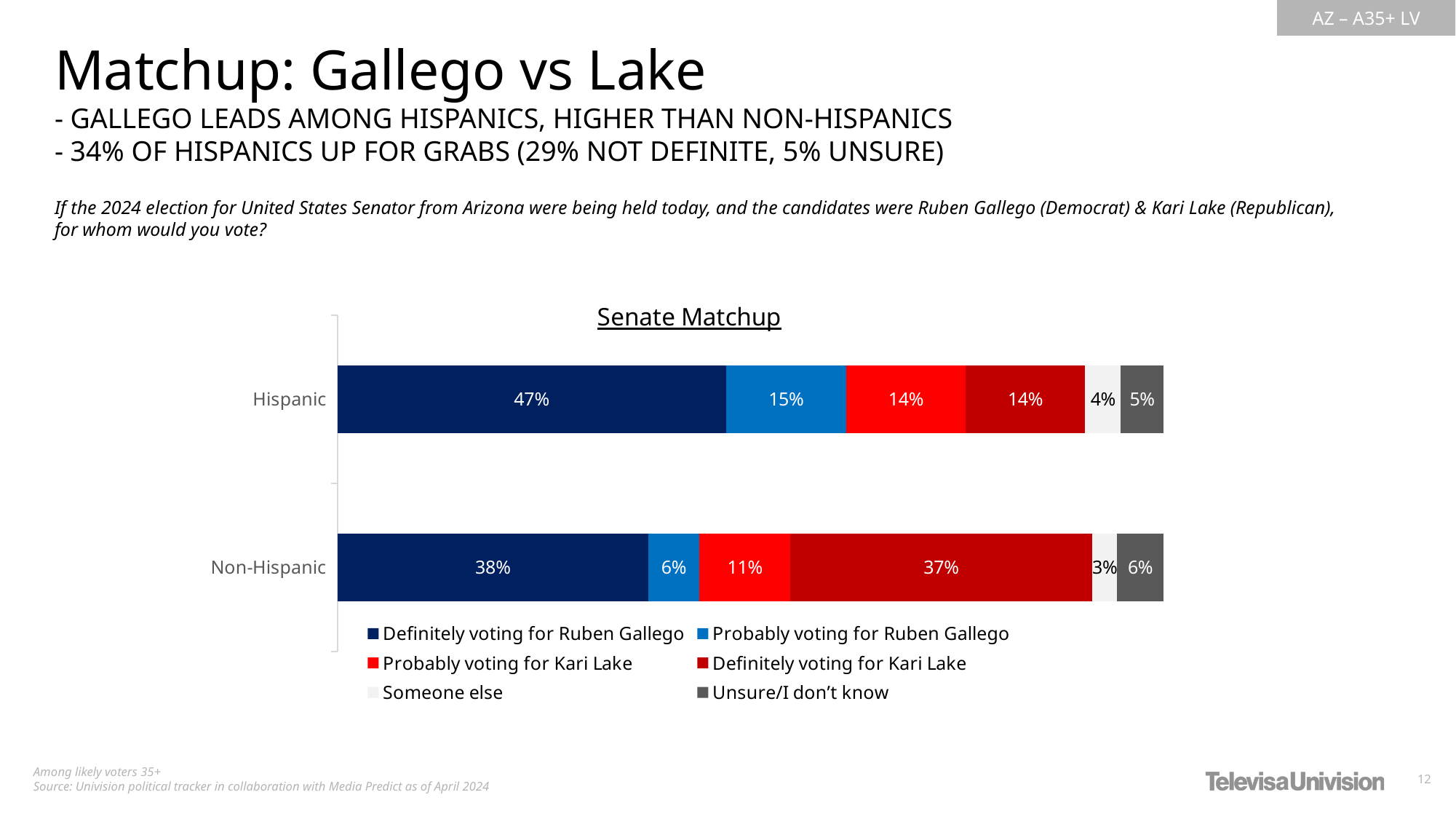
What is the difference between the Hispanic and Non-Hispanic shares definitely voting for Ruben Gallego? 9% What percentage of Hispanic respondents answered Unsure/I don't know? 5% Which group has a larger share definitely voting for Kari Lake, Hispanic or Non-Hispanic? Non-Hispanic How many series does the legend list? 6 What is the total of the Hispanic bar? 99% What kind of chart is shown? Stacked bar chart What is the total of the Non-Hispanic bar? 101% What percentage of Hispanic respondents are definitely voting for Ruben Gallego? 47% Which group has a larger share probably voting for Ruben Gallego, Hispanic or Non-Hispanic? Hispanic What percentage of Non-Hispanic respondents are probably voting for Ruben Gallego? 6% What is the title of the chart? Senate Matchup What percentage of Non-Hispanic respondents are definitely voting for Kari Lake? 37%